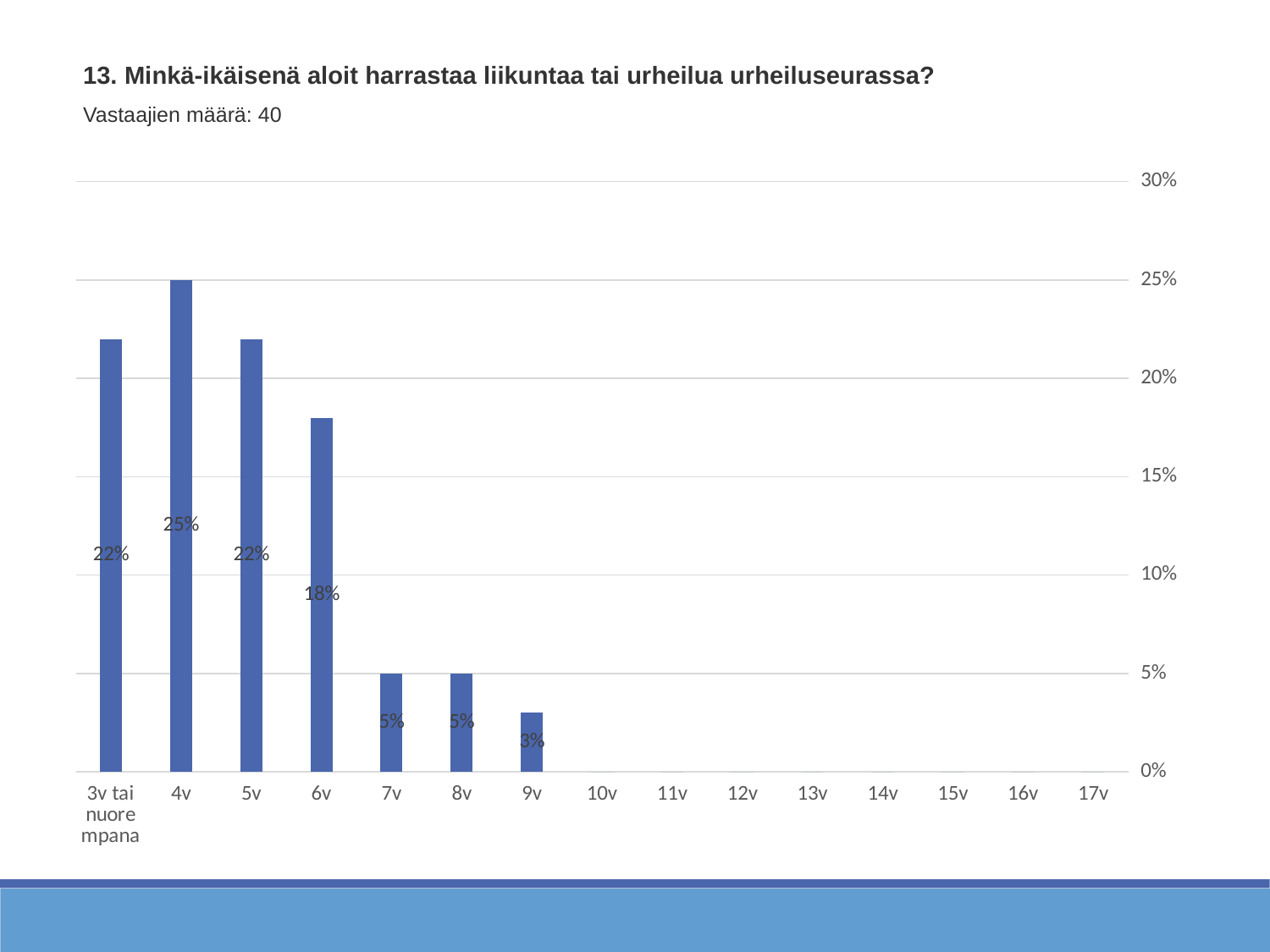
What is the difference between the values for 4v and 6v? 7% What is the value for 3v tai nuorempana? 22% Is the value for 6v greater or less than 20%? less What is the value for 6v? 18% What is the number of respondents (Vastaajien määrä) stated on the slide? 40 Which is larger, the value for 5v or the value for 7v? 5v What is the value for 4v? 25% What is the value for 9v? 3% What kind of chart is shown on the slide? bar chart Among the categories with a visible bar, which has the lowest value? 9v Which category has the highest value? 4v How many categories are shown on the x axis? 15